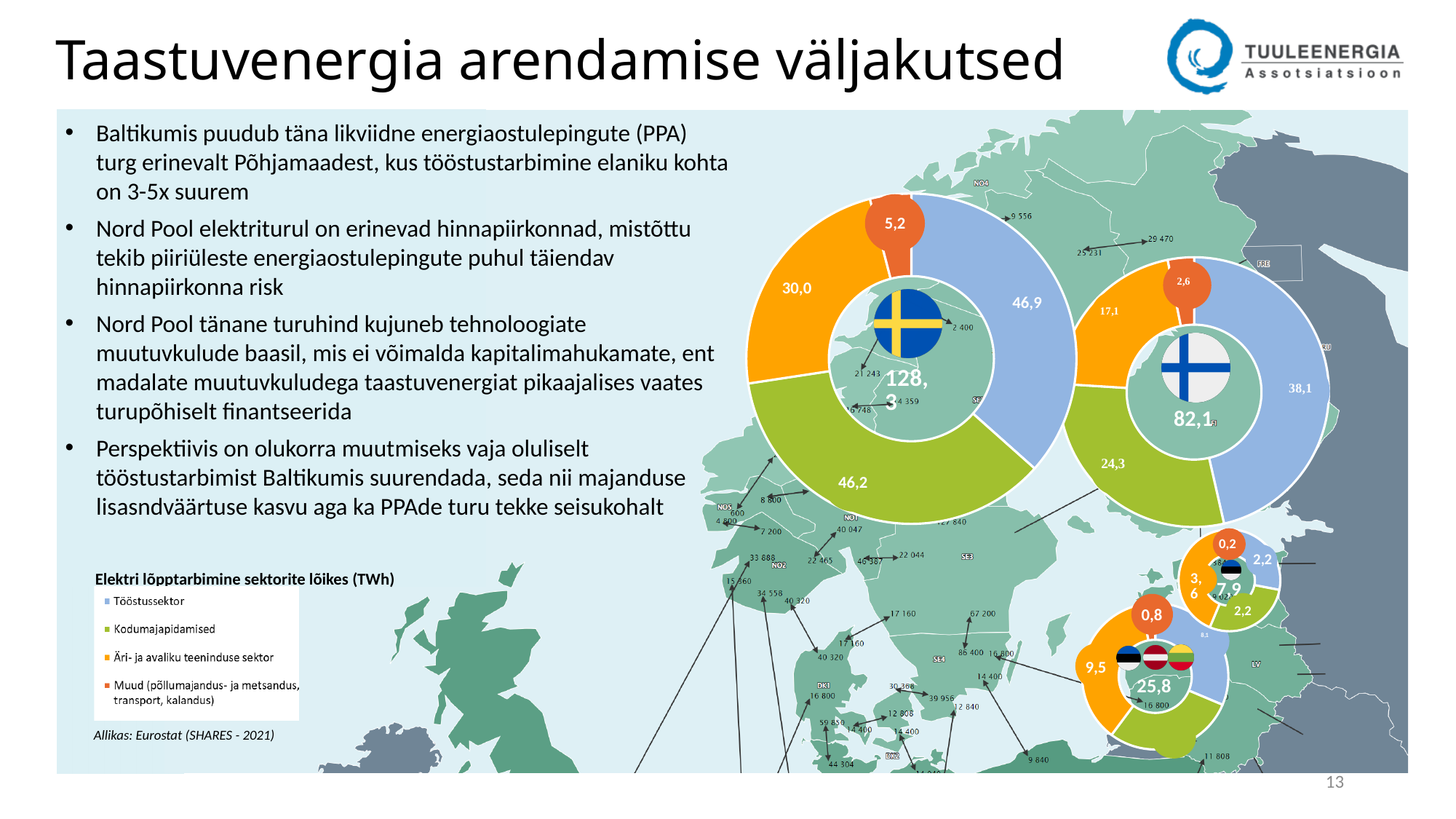
What kind of chart is used to show electricity consumption by sector for each country on the map? Pie (donut) chart What total is shown in the centre of the Finland donut chart? 82,1 What is the title of the chart legend on the slide? Elektri lõpptarbimine sektorite lõikes (TWh) In the Sweden donut chart, what is the value for Tööstussektor? 46,9 How many sectors does the legend of the electricity consumption charts list? 4 In the Finland donut chart, which sector has the largest value? Tööstussektor What total electricity consumption (TWh) is shown in the centre of the Sweden donut chart? 128,3 In the Finland donut chart, what is the difference between Tööstussektor (38,1) and Kodumajapidamised (24,3)? 13,8 In the Sweden donut chart, what is the value for Muud (põllumajandus- ja metsandus, transport, kalandus)? 5,2 In the Sweden donut chart, which sector has the smallest value? Muud (põllumajandus- ja metsandus, transport, kalandus) Which country has the larger total electricity consumption shown in its donut centre, Sweden (128,3) or Finland (82,1)? Sweden In the Finland donut chart, what is the value for Kodumajapidamised? 24,3